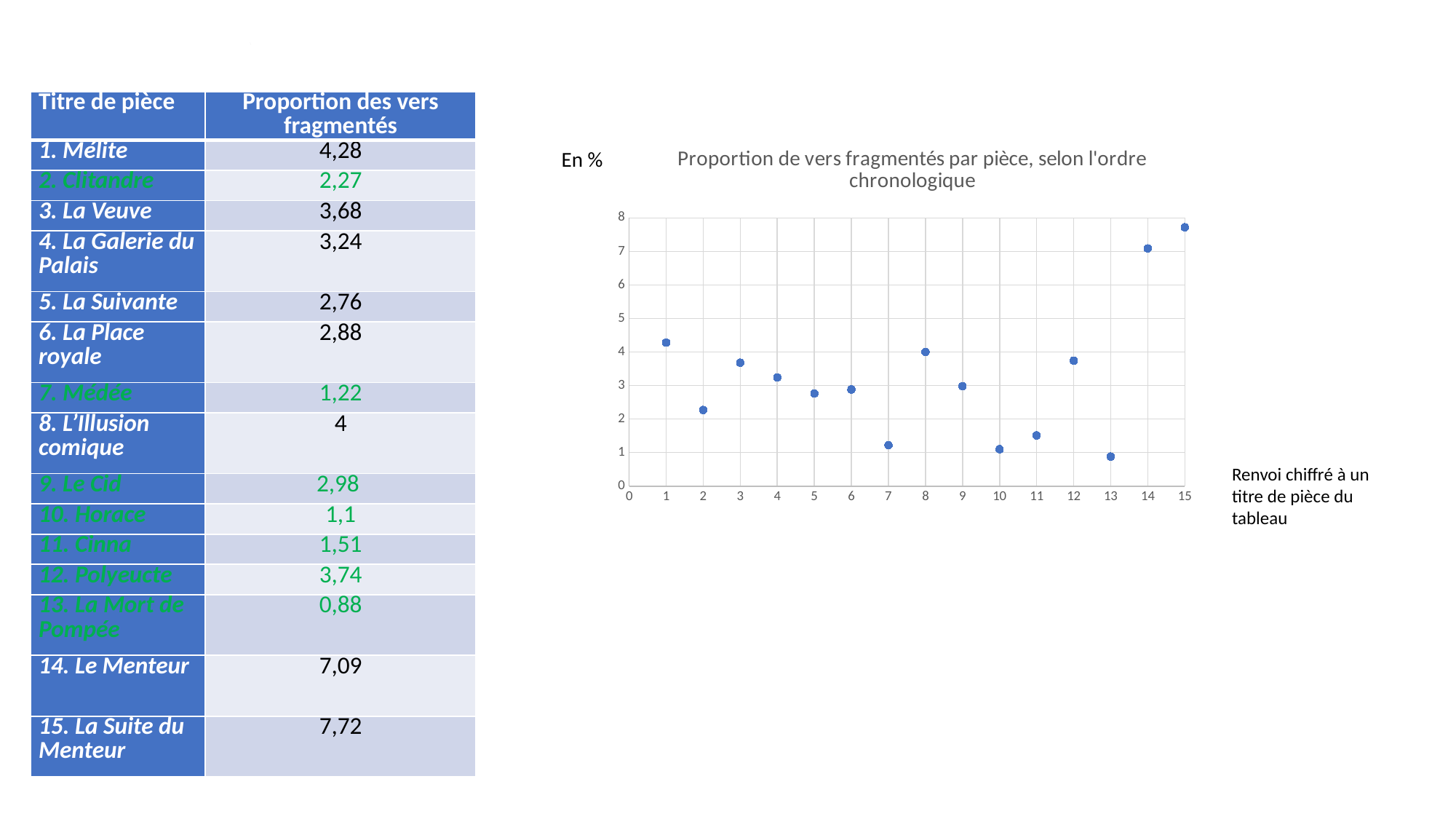
Which x-axis position has the highest plotted value in the chart? 15 What is the plotted value at x = 8 in the chart? 4 Which plotted value is larger, the one at x = 3 or the one at x = 4? x = 3 Is the plotted value at x = 15 greater or less than 7? greater Is the plotted value at x = 7 greater or less than 2? less How many data points are plotted in the chart? 15 Is the plotted value at x = 12 greater or less than 3? greater What kind of chart is shown on the slide? scatter chart Which plotted value is larger, the one at x = 8 or the one at x = 9? x = 8 Do the plotted values rise or fall from x = 13 to x = 15? rise Which x-axis position has the lowest plotted value in the chart? 13 What is the title of the chart? Proportion de vers fragmentés par pièce, selon l'ordre chronologique